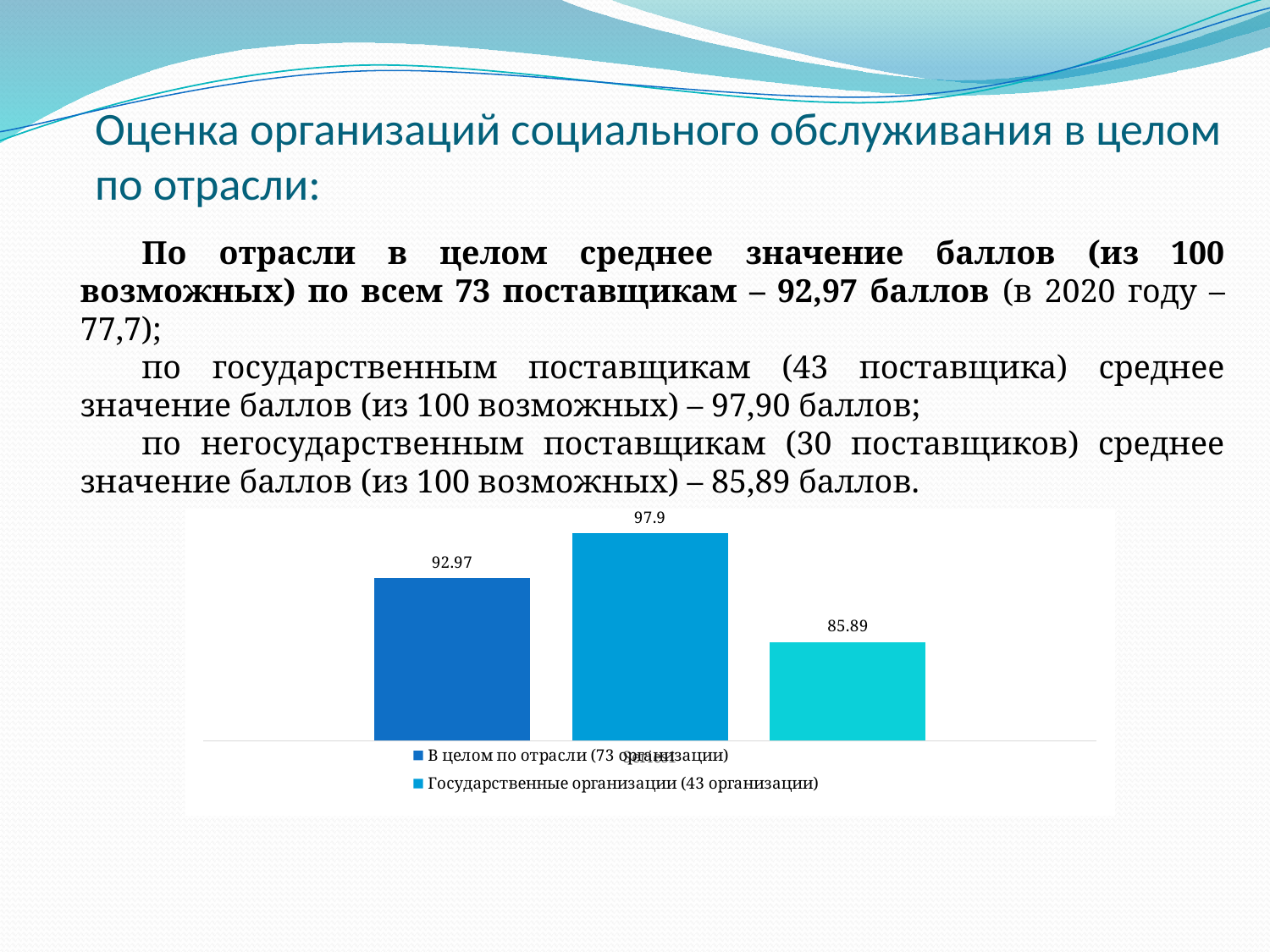
What is the value of the bar for "В целом по отрасли (73 организации)"? 92.97 What is the lowest value shown in the chart? 85.89 What is the value of the bar for "Государственные организации (43 организации)"? 97.9 Do the bar values rise or fall from the second bar to the third bar? fall What is the difference between the highest and lowest bar values in the chart? 12.01 What is the value of the third (rightmost, light cyan) bar in the chart? 85.89 How many bars are plotted in the chart? 3 What is the first legend entry listed below the chart? В целом по отрасли (73 организации) Which bar has the highest value in the chart? Государственные организации (43 организации) Which is larger: the value for "В целом по отрасли (73 организации)" or the rightmost bar? В целом по отрасли (73 организации) What type of chart is shown on the slide? bar chart What is the difference between the values for "Государственные организации (43 организации)" and "В целом по отрасли (73 организации)"? 4.93